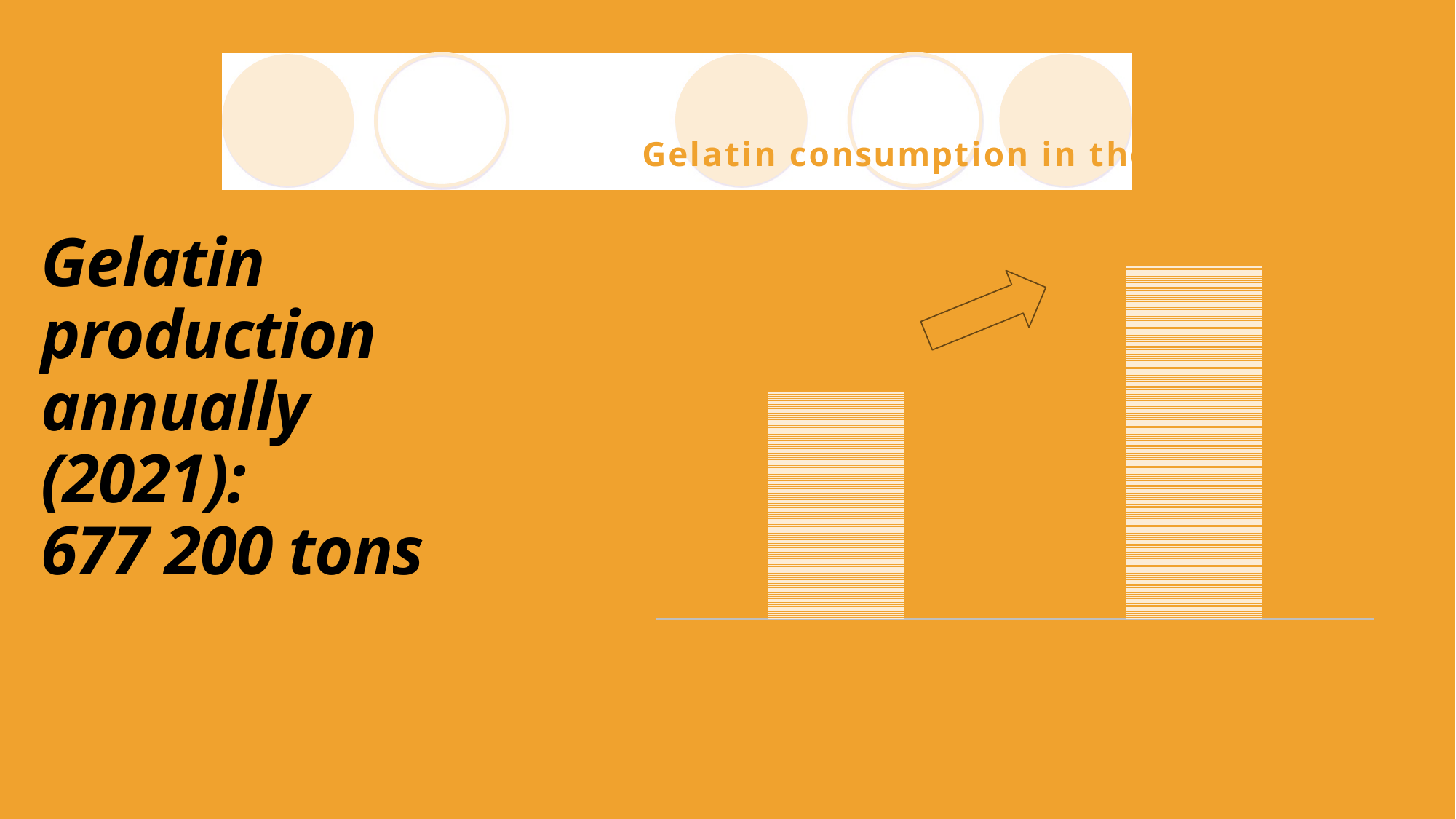
Which bar is taller, the left bar or the right bar? the right bar Which bar is the highest, the left or the right? the right bar How many bars does the chart show? 2 Which bar is the lowest, the left or the right? the left bar In which direction does the arrow above the bars point? up and to the right What kind of chart is shown on the slide? bar chart Do the bar values rise or fall from left to right? rise Does the chart display a legend? No